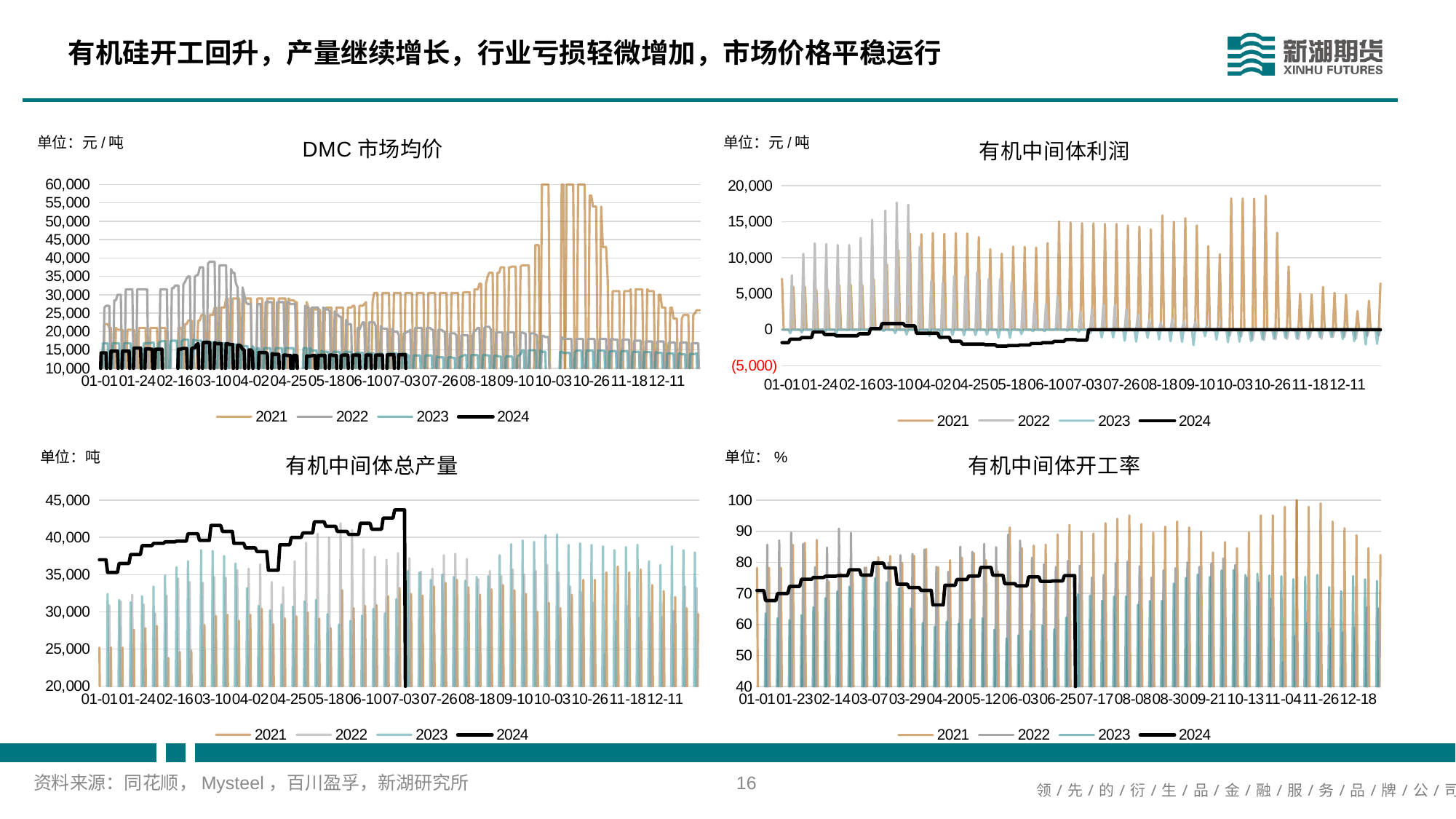
What unit is shown for the 有机中间体开工率 chart? % In the DMC 市场均价 chart, is the highest value of the 2024 series greater or less than 20,000? less What kind of chart is the DMC 市场均价 chart? line chart In the DMC 市场均价 chart, which series reaches a higher peak, 2021 or 2023? 2021 What unit is shown for the 有机中间体总产量 chart? 吨 In the 有机中间体利润 chart, is the lowest value of the 2024 series greater or less than 0? less How many series does the legend of the 有机中间体利润 chart list? 4 In the 有机中间体开工率 chart, is the highest value of the 2021 series greater or less than 90? greater In the 有机中间体总产量 chart, does the 2024 series generally rise or fall from 01-01 to 07-03? rise